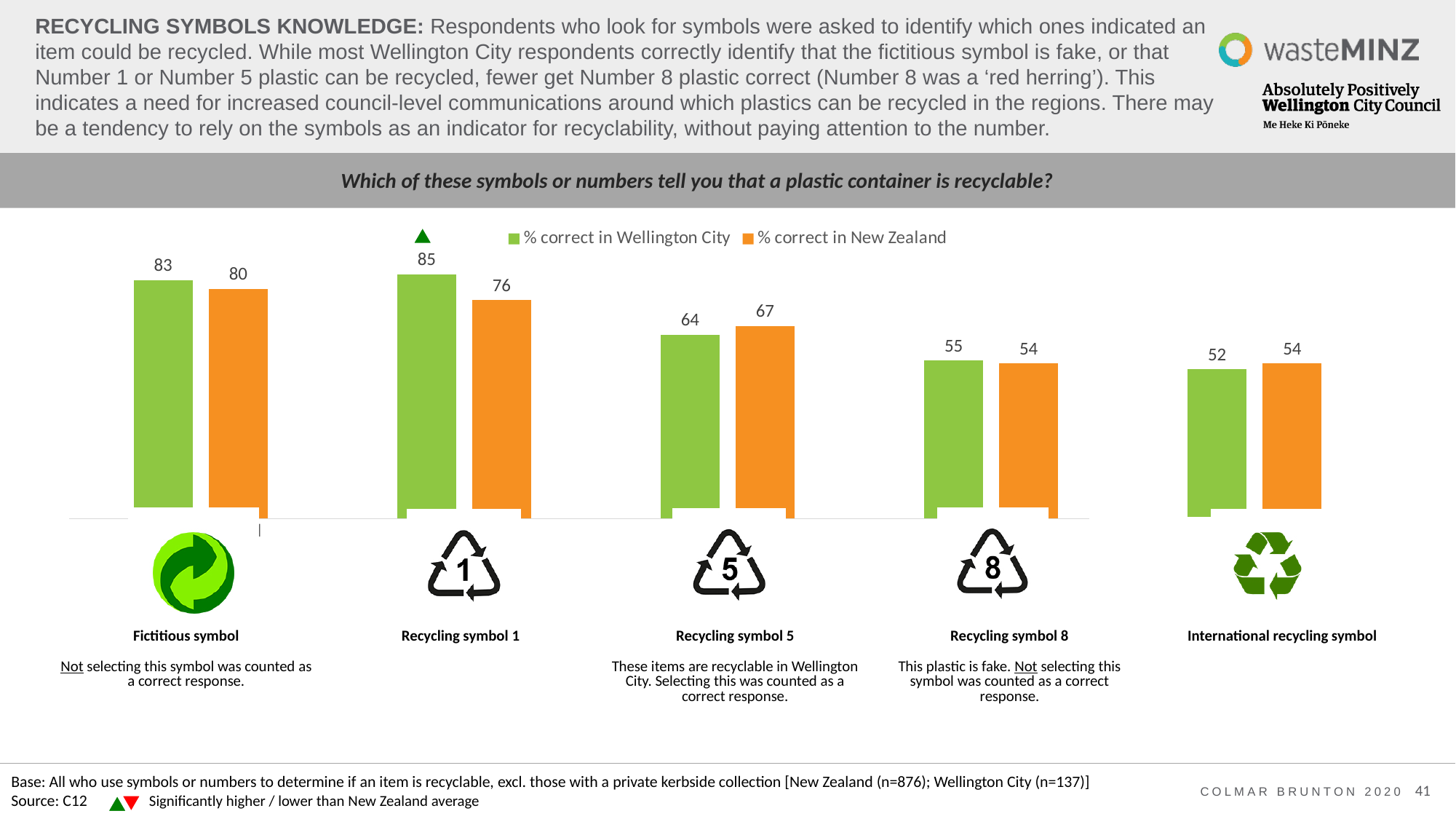
How many symbols are shown on the chart? 5 Which colour represents % correct in New Zealand in the chart? Orange How many series does the legend list? 2 What is the % correct in New Zealand for Recycling symbol 1? 76 For Recycling symbol 5, which is larger: % correct in Wellington City or % correct in New Zealand? % correct in New Zealand Which symbol has the highest % correct in Wellington City? Recycling symbol 1 What is the % correct in Wellington City for the Fictitious symbol? 83 What is the difference between the Wellington City and New Zealand % correct for Recycling symbol 1? 9 What kind of chart is shown on the slide? Bar chart Which symbol has the lowest % correct in Wellington City? International recycling symbol What is the % correct in Wellington City for Recycling symbol 8? 55 What is the % correct in New Zealand for the International recycling symbol? 54